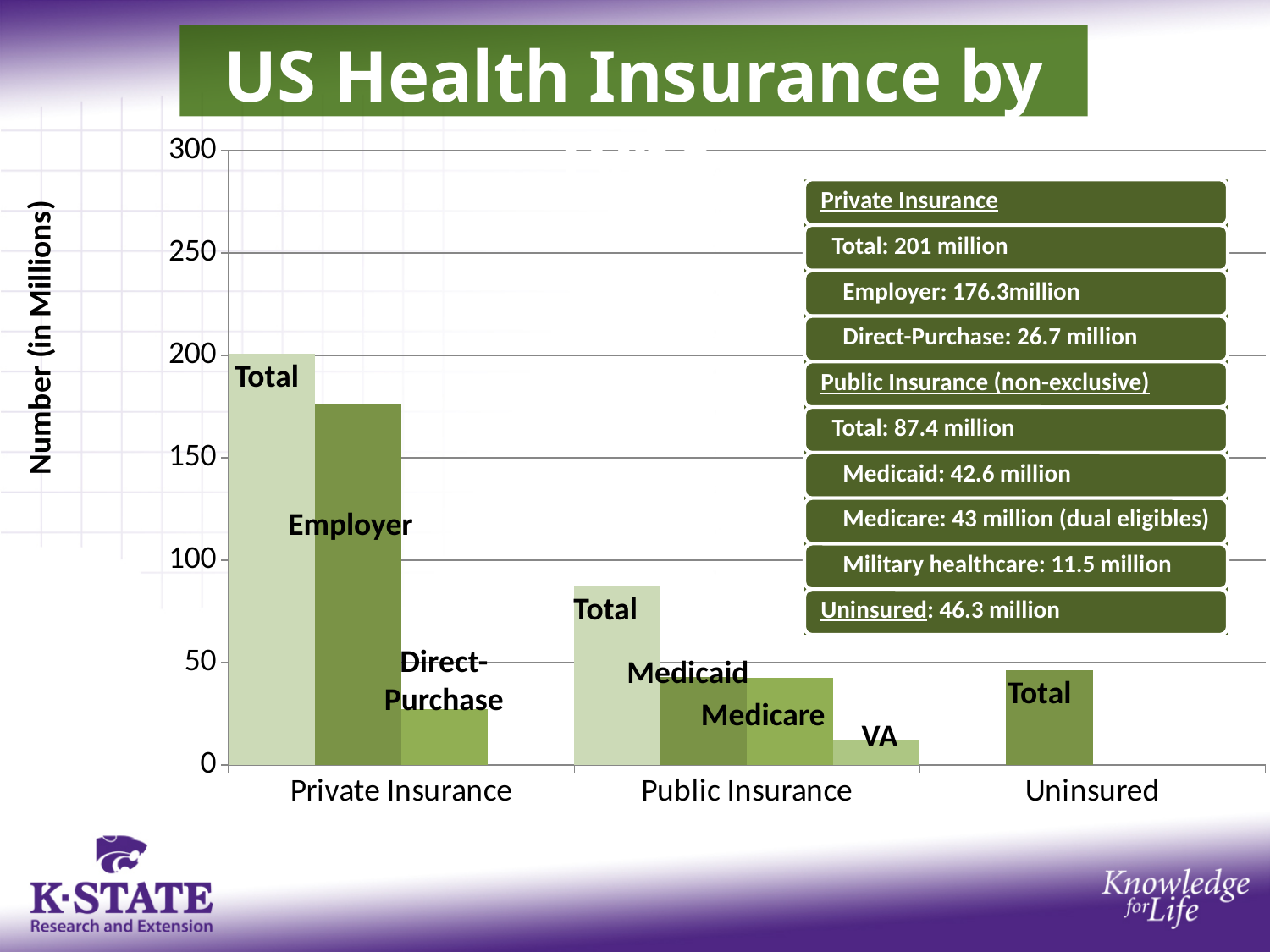
Which bar is the tallest on the chart? Private Insurance Total Is the value of the Employer bar greater or less than 150? greater What is the value of the Uninsured Total bar? 46.3 million What is the value of the Medicaid bar? 42.6 million What is the difference between the Employer bar and the Direct-Purchase bar? 149.6 million How many category groups are shown along the x axis? 3 What is the value of the Employer bar in the Private Insurance group? 176.3 million What is the value of the Total bar for Private Insurance? 201 million Which is larger, the Public Insurance Total bar or the Uninsured Total bar? Public Insurance Total What is the value of the Direct-Purchase bar? 26.7 million What is the value of the Total bar for Public Insurance? 87.4 million Which bar is the shortest on the chart? VA